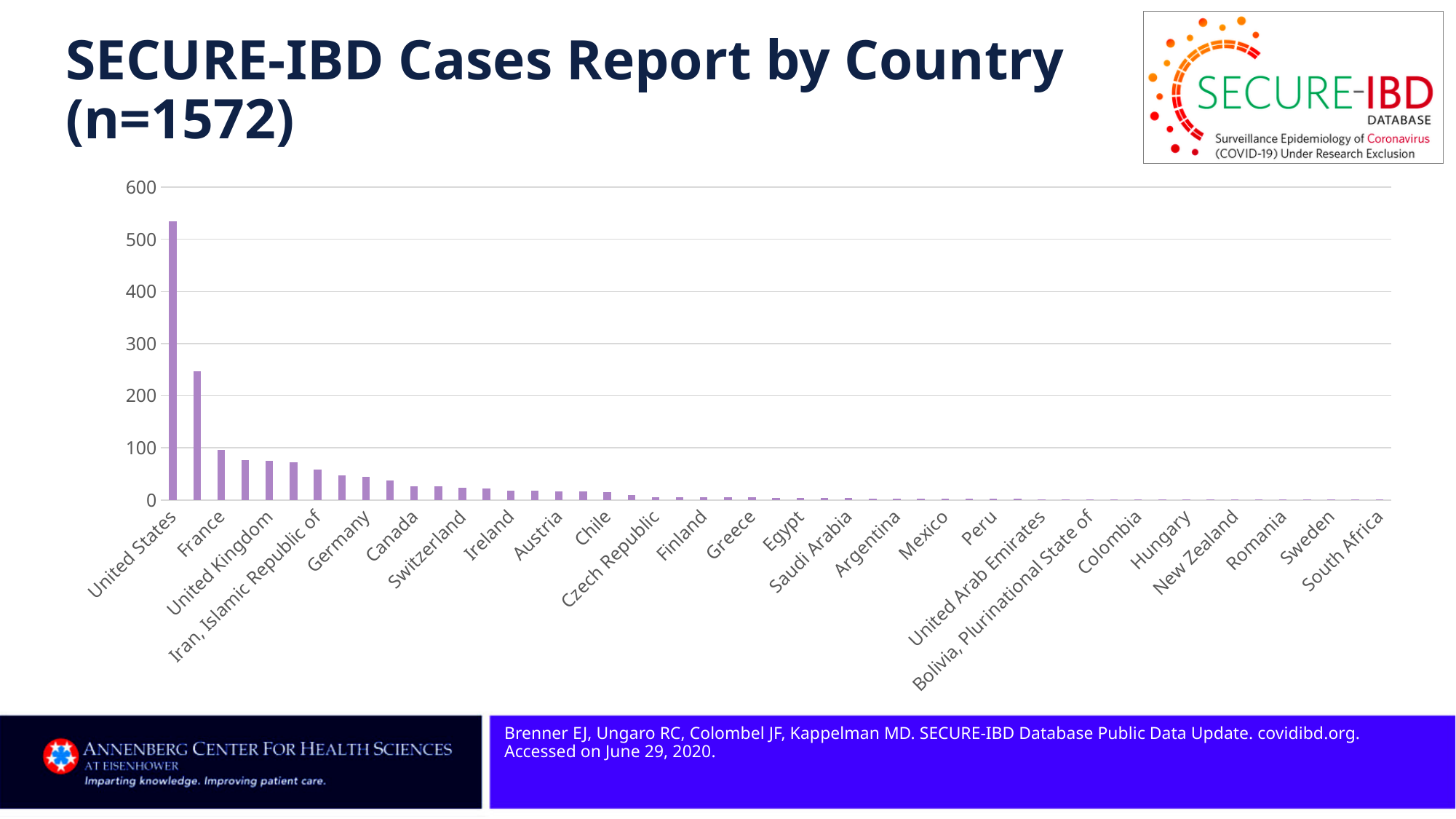
Do the values rise or fall moving from left to right along the x axis? fall Which has more cases, France or Germany? France What colour are the bars in the chart? purple Is the value for France greater or less than 300? less What kind of chart is shown on the slide? bar chart Is the value for United Kingdom greater or less than 100? less Which country has the highest number of cases? United States Is the value for Germany greater or less than 100? less Which has more cases, United States or France? United States What is the title of the slide containing the chart? SECURE-IBD Cases Report by Country (n=1572)